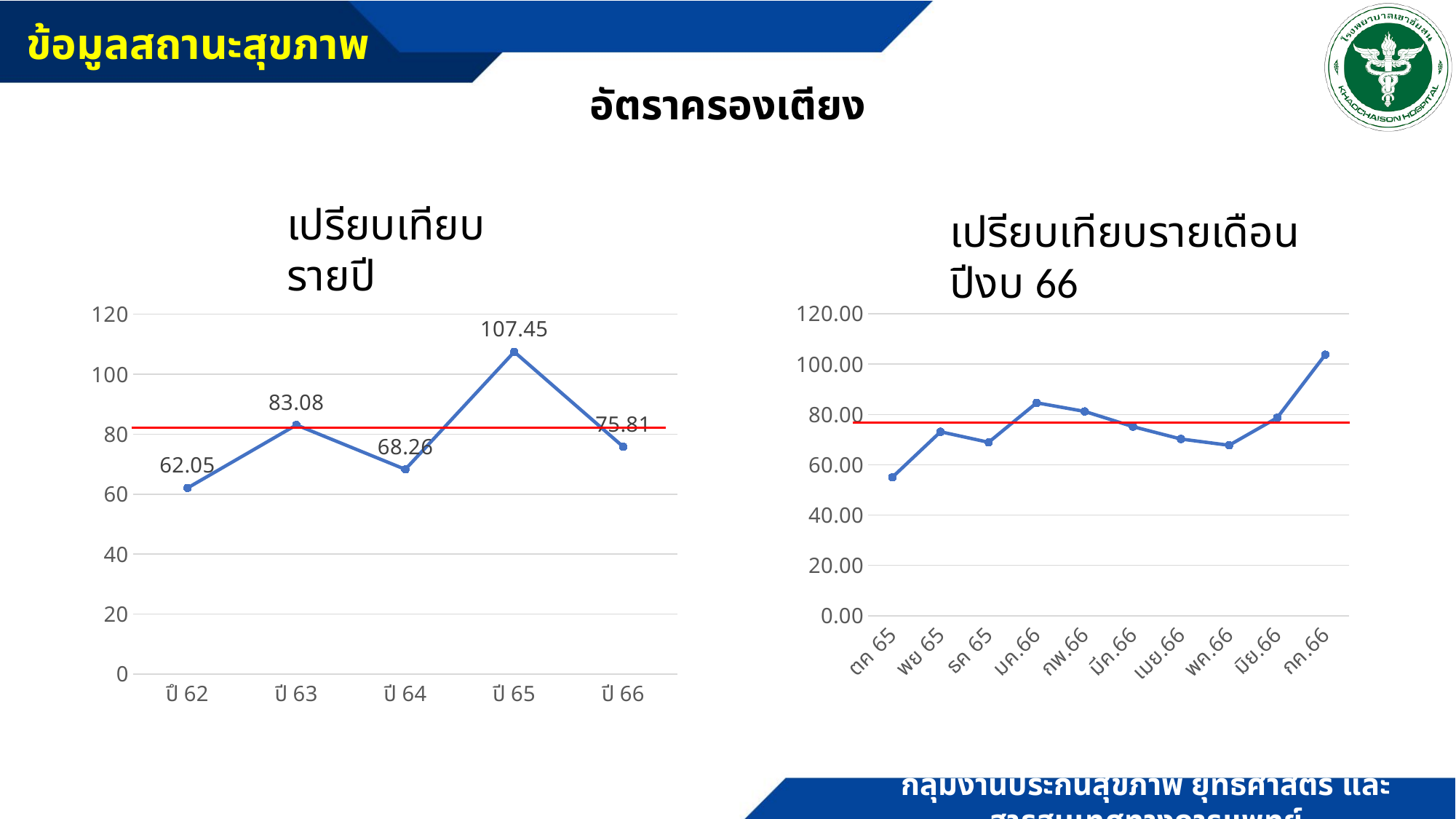
In the left chart (เปรียบเทียบรายปี), how many years are plotted? 5 What kind of chart is the right chart (เปรียบเทียบรายเดือน ปีงบ 66)? Line chart In the right chart (เปรียบเทียบรายเดือน ปีงบ 66), is the value for กค.66 greater or less than 100.00? greater In the left chart (เปรียบเทียบรายปี), which is larger, the value for ปี 63 or ปี 64? ปี 63 In the left chart (เปรียบเทียบรายปี), what is the value for ปี 62? 62.05 In the right chart (เปรียบเทียบรายเดือน ปีงบ 66), how many months are plotted? 10 In the right chart (เปรียบเทียบรายเดือน ปีงบ 66), is the value for ตค 65 greater or less than 60.00? less In the left chart (เปรียบเทียบรายปี), which year has the lowest value? ปี 62 In the left chart (เปรียบเทียบรายปี), what is the value for ปี 65? 107.45 In the left chart (เปรียบเทียบรายปี), what is the value for ปี 66? 75.81 In the left chart (เปรียบเทียบรายปี), what is the difference between the values for ปี 65 and ปี 66? 31.64 In the left chart (เปรียบเทียบรายปี), which year has the highest value? ปี 65